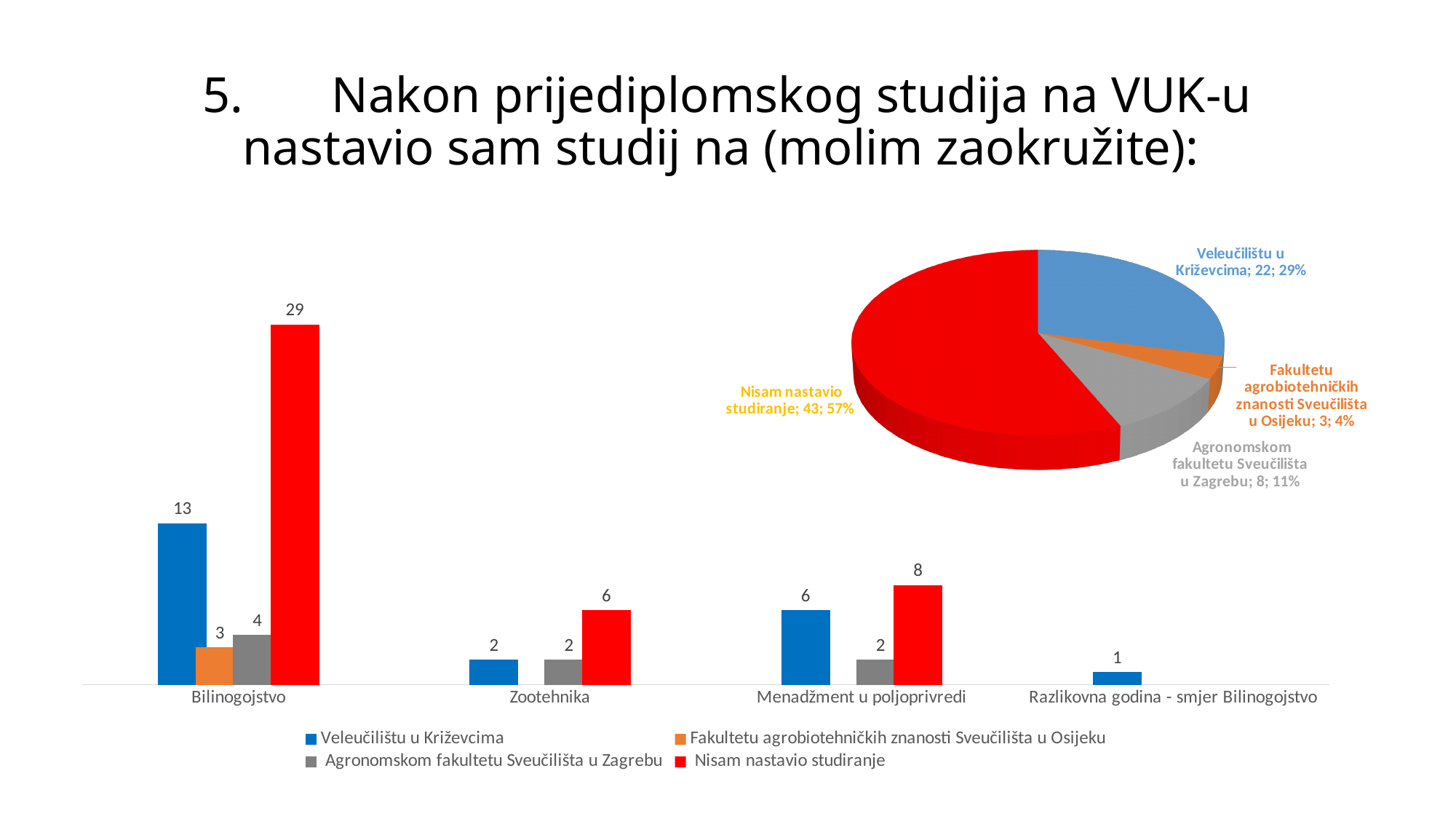
In the bar chart on the left, what is the value for 'Agronomskom fakultetu Sveučilišta u Zagrebu' in the Zootehnika category? 2 How many series does the legend of the bar chart on the left list? 4 In the bar chart on the left, what is the difference between 'Nisam nastavio studiranje' and 'Veleučilištu u Križevcima' in the Bilinogojstvo category? 16 In the bar chart on the left, what is the value for 'Nisam nastavio studiranje' in the Bilinogojstvo category? 29 In the bar chart on the left, which is larger in the Menadžment u poljoprivredi category: 'Veleučilištu u Križevcima' or 'Nisam nastavio studiranje'? Nisam nastavio studiranje In the pie chart on the right, what is the value for 'Veleučilištu u Križevcima'? 22 In the pie chart on the right, which slice is the smallest? Fakultetu agrobiotehničkih znanosti Sveučilišta u Osijeku What kind of chart is the chart on the left of the slide? Bar chart In the bar chart on the left, what is the value for 'Veleučilištu u Križevcima' in the Menadžment u poljoprivredi category? 6 In the pie chart on the right, what share does 'Nisam nastavio studiranje' have? 57% In the bar chart on the left, which category has the highest value for 'Nisam nastavio studiranje'? Bilinogojstvo How many categories are shown on the x axis of the bar chart on the left? 4